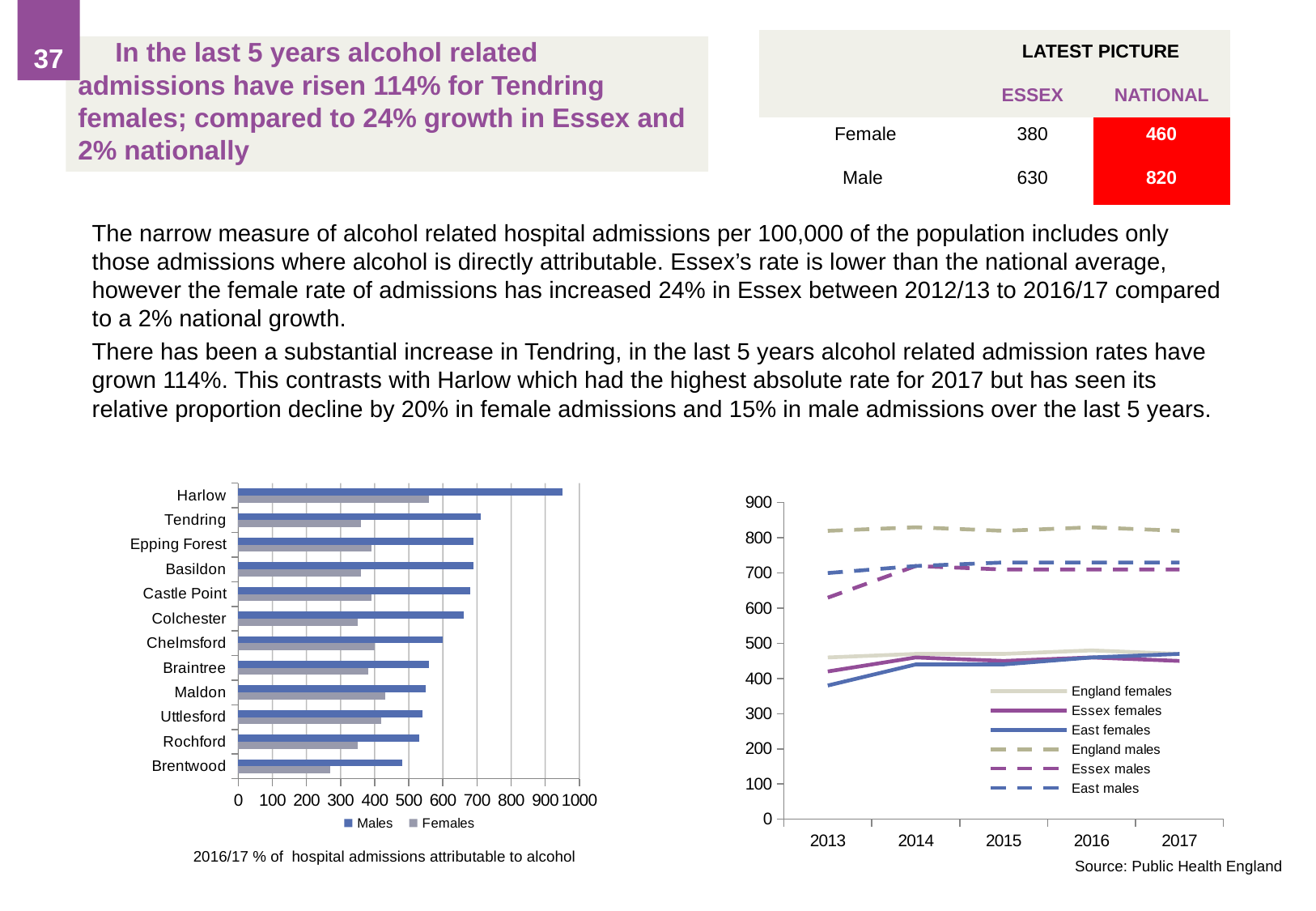
On the left bar chart, which district has the highest value for Males? Harlow What kind of chart is the chart on the left of the slide? bar chart On the right line chart, does the Essex males line rise or fall between 2013 and 2014? rise How many series does the legend of the left bar chart list? 2 On the left bar chart, is the Females value for Brentwood greater or less than 300? less On the left bar chart, which district has the lowest value for Males? Brentwood On the left bar chart, is the Males value for Harlow greater or less than 900? greater How many series does the legend of the right line chart list? 6 How many districts are listed on the left bar chart? 12 On the right line chart, which series has the highest values across all years? England males On the left bar chart, which is larger: the Males value for Tendring or the Males value for Brentwood? Tendring How many years are shown on the x axis of the right line chart? 5